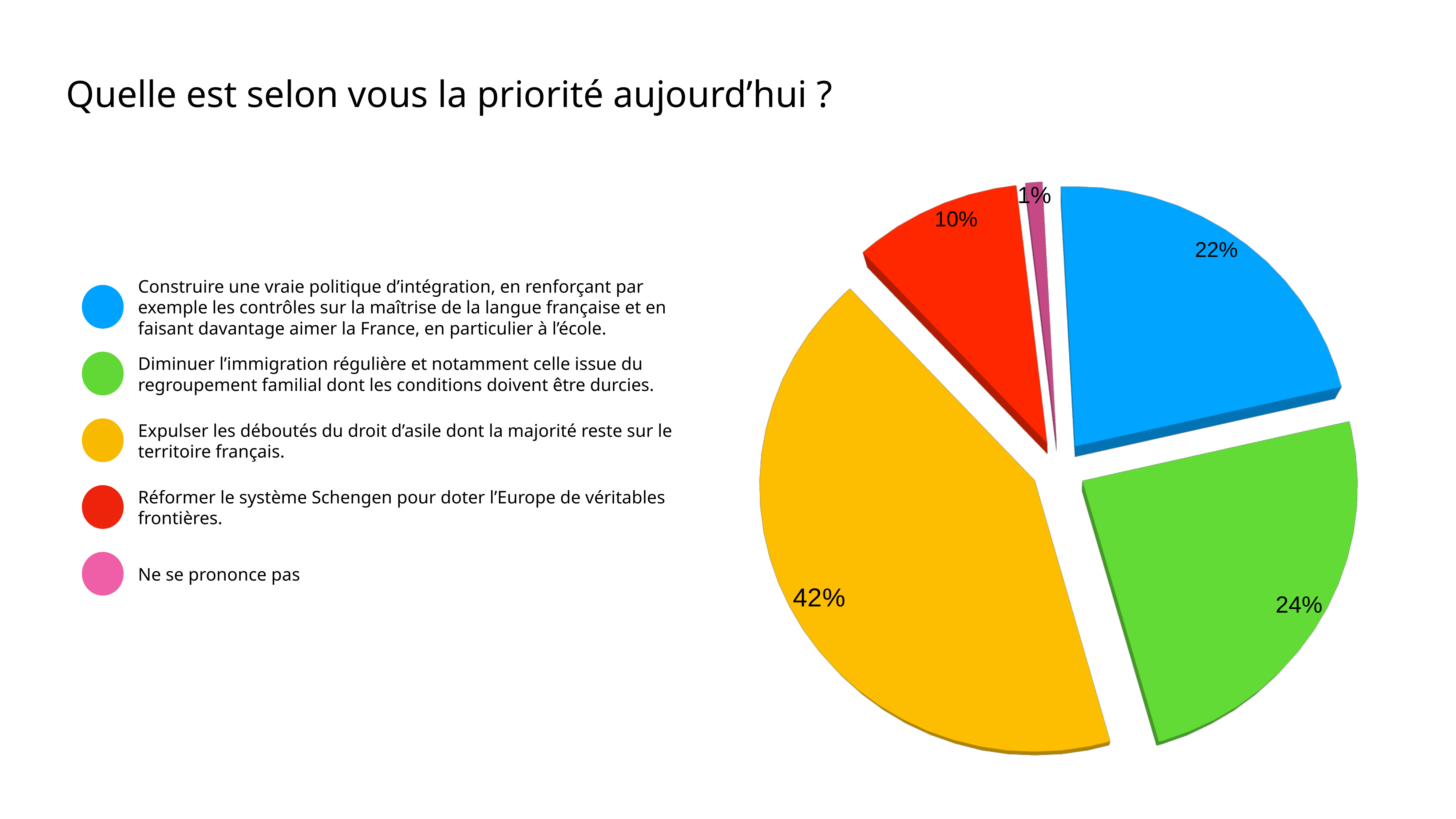
What colour is the slice representing Ne se prononce pas? pink What is the value shown for the green slice (Diminuer l'immigration régulière)? 24% Which is larger: the share for Diminuer l'immigration régulière or the share for Réformer le système Schengen? Diminuer l'immigration régulière What is the value shown for the pink slice (Ne se prononce pas)? 1% Which option has the smallest share of the pie? Ne se prononce pas What kind of chart is shown on the slide? pie chart What share of the pie does the yellow slice (Expulser les déboutés du droit d'asile) represent? 42% What is the value shown for the red slice (Réformer le système Schengen)? 10% What is the value shown for the blue slice (Construire une vraie politique d'intégration)? 22% Which option has the largest share of the pie? Expulser les déboutés du droit d'asile dont la majorité reste sur le territoire français. What is the difference between the yellow slice (42%) and the green slice (24%)? 18% How many slices does the pie chart have? 5